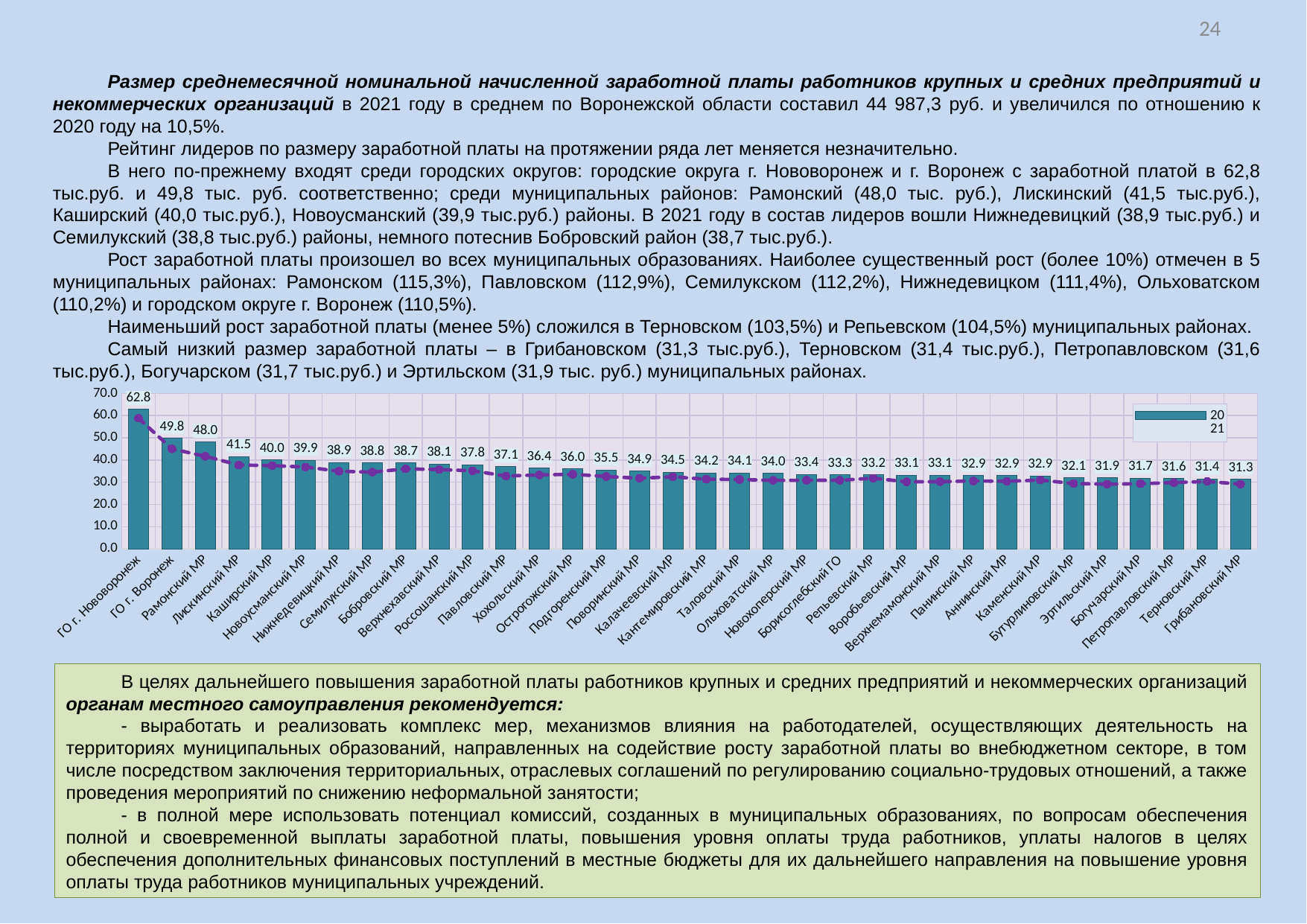
Which category has the lowest bar? Грибановский МР How many categories are shown on the x axis? 34 Which category has the highest bar? ГО г. Нововоронеж Which is larger, the value for Лискинский МР or the value for Каширский МР? Лискинский МР What kind of chart is shown on the slide? combination bar and line chart Is the value for Семилукский МР greater or less than 30.0? greater What is the difference between the values for ГО г. Нововоронеж and ГО г. Воронеж? 13.0 What is the value shown for Грибановский МР? 31.3 What is the value shown for Борисоглебский ГО? 33.3 Do the bar values rise or fall from left to right along the x axis? fall What is the value shown for Рамонский МР? 48.0 What is the value shown for ГО г. Нововоронеж? 62.8